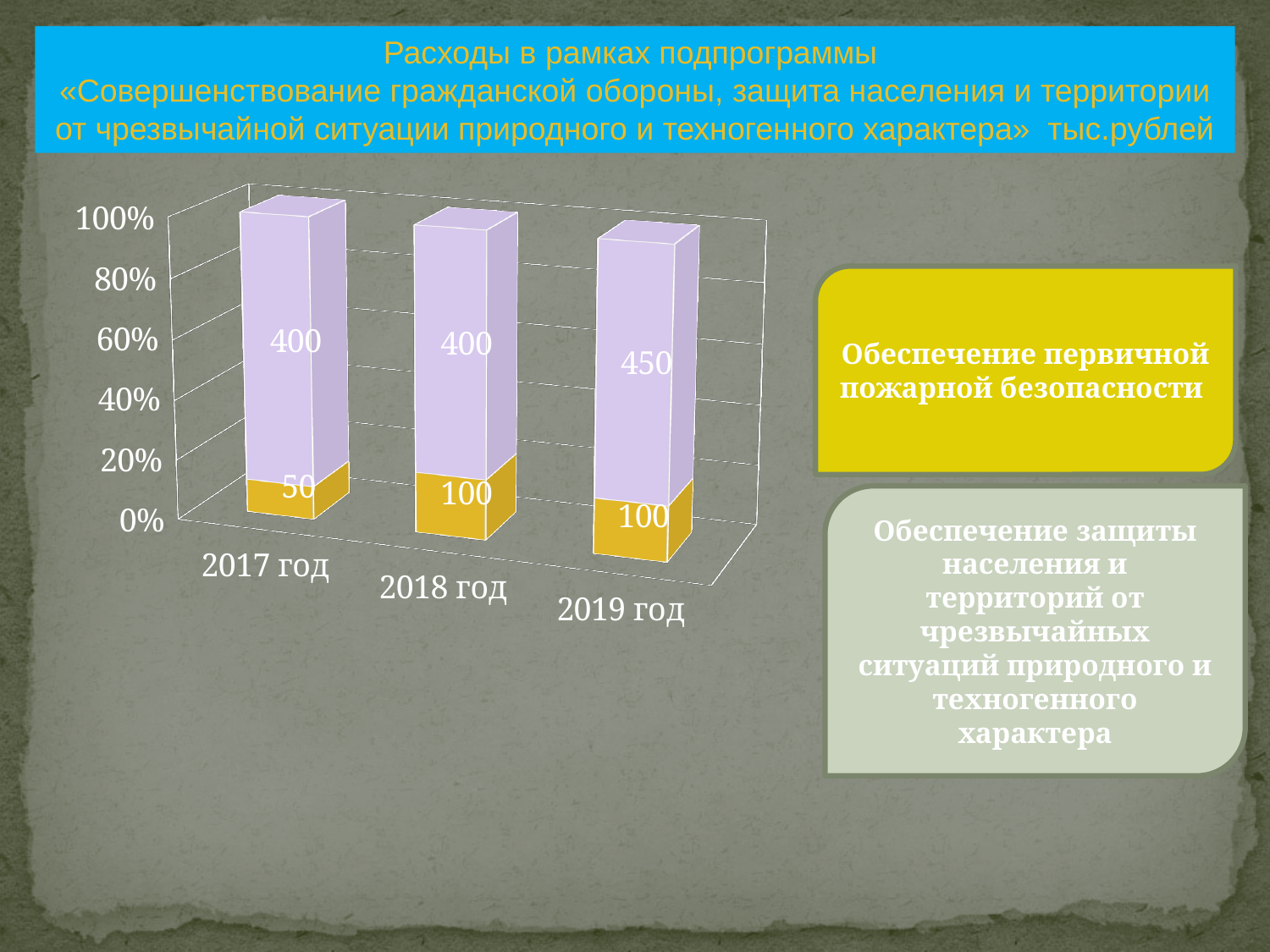
What is the value printed on the lower (yellow) segment of the bar for 2018 год? 100 Which year has the highest value in the upper (purple) segment? 2019 год What is the value printed on the upper (purple) segment of the bar for 2019 год? 450 Which year has the lowest value in the lower (yellow) segment? 2017 год What is the total of the two segments in the bar for 2019 год? 550 What is the value printed on the lower (yellow) segment of the bar for 2017 год? 50 How many years are shown on the x axis of the chart? 3 What kind of chart is shown on the slide? Stacked bar chart Do the bar totals rise or fall from 2017 год to 2019 год? Rise By how much does the upper (purple) segment value for 2019 год exceed that for 2017 год? 50 What is the total of the two segments in the bar for 2017 год? 450 Which is larger: the lower (yellow) segment value for 2017 год or for 2018 год? 2018 год